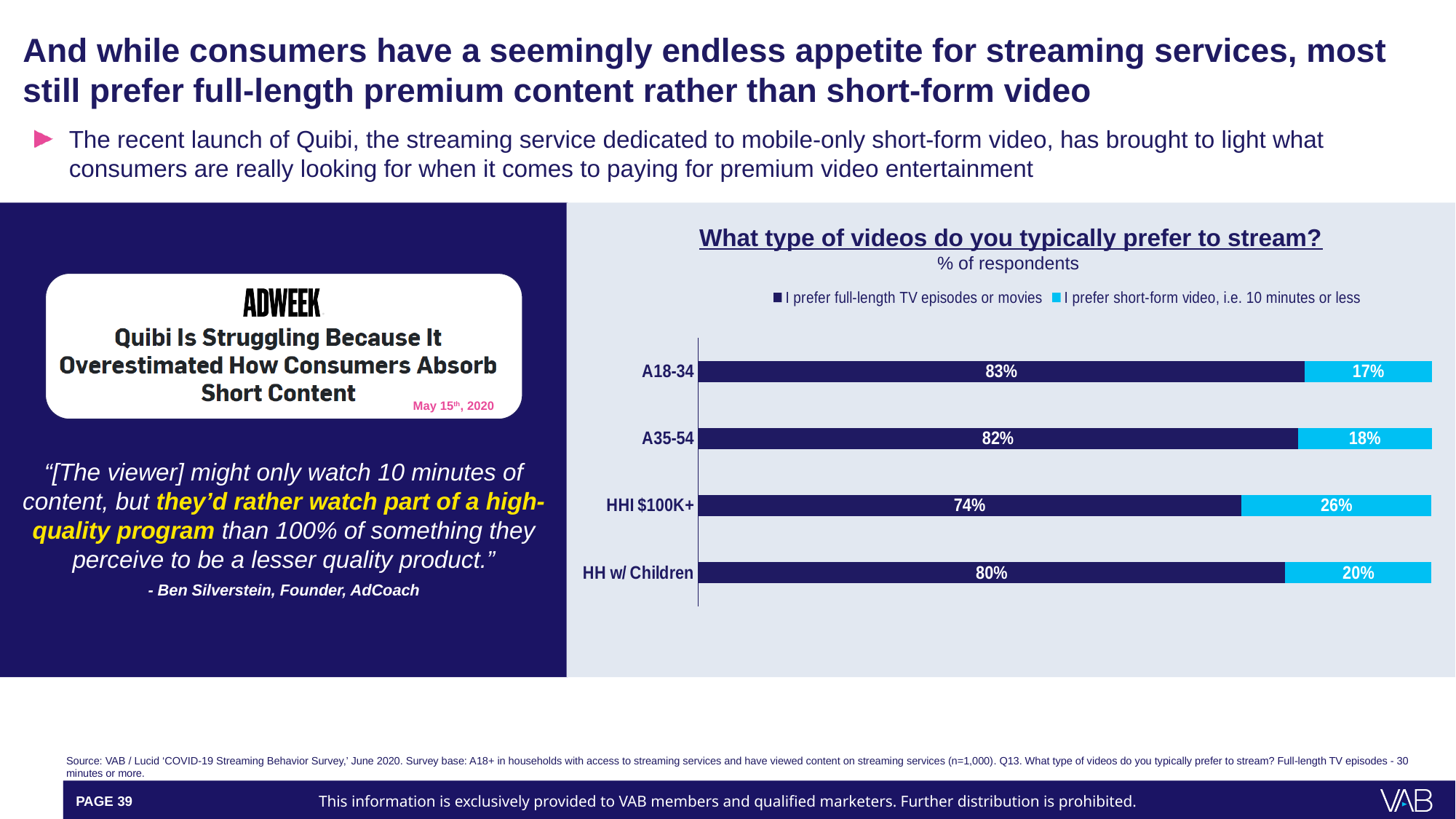
What is the difference between the full-length preference for A18-34 and HHI $100K+? 9 percentage points What percentage of HHI $100K+ respondents prefer short-form video, i.e. 10 minutes or less? 26% What percentage of HH w/ Children respondents prefer full-length TV episodes or movies? 80% Which category has the lowest share preferring full-length TV episodes or movies? HHI $100K+ What is the title of the chart? What type of videos do you typically prefer to stream? Which category has the highest share preferring full-length TV episodes or movies? A18-34 How many categories are shown in the chart? 4 What percentage of A18-34 respondents prefer full-length TV episodes or movies? 83% How many series does the legend list? 2 What is the total of the two segments for the A35-54 bar? 100% Which is larger: the short-form video share for A35-54 or for HH w/ Children? HH w/ Children What kind of chart is shown on the slide? Stacked horizontal bar chart